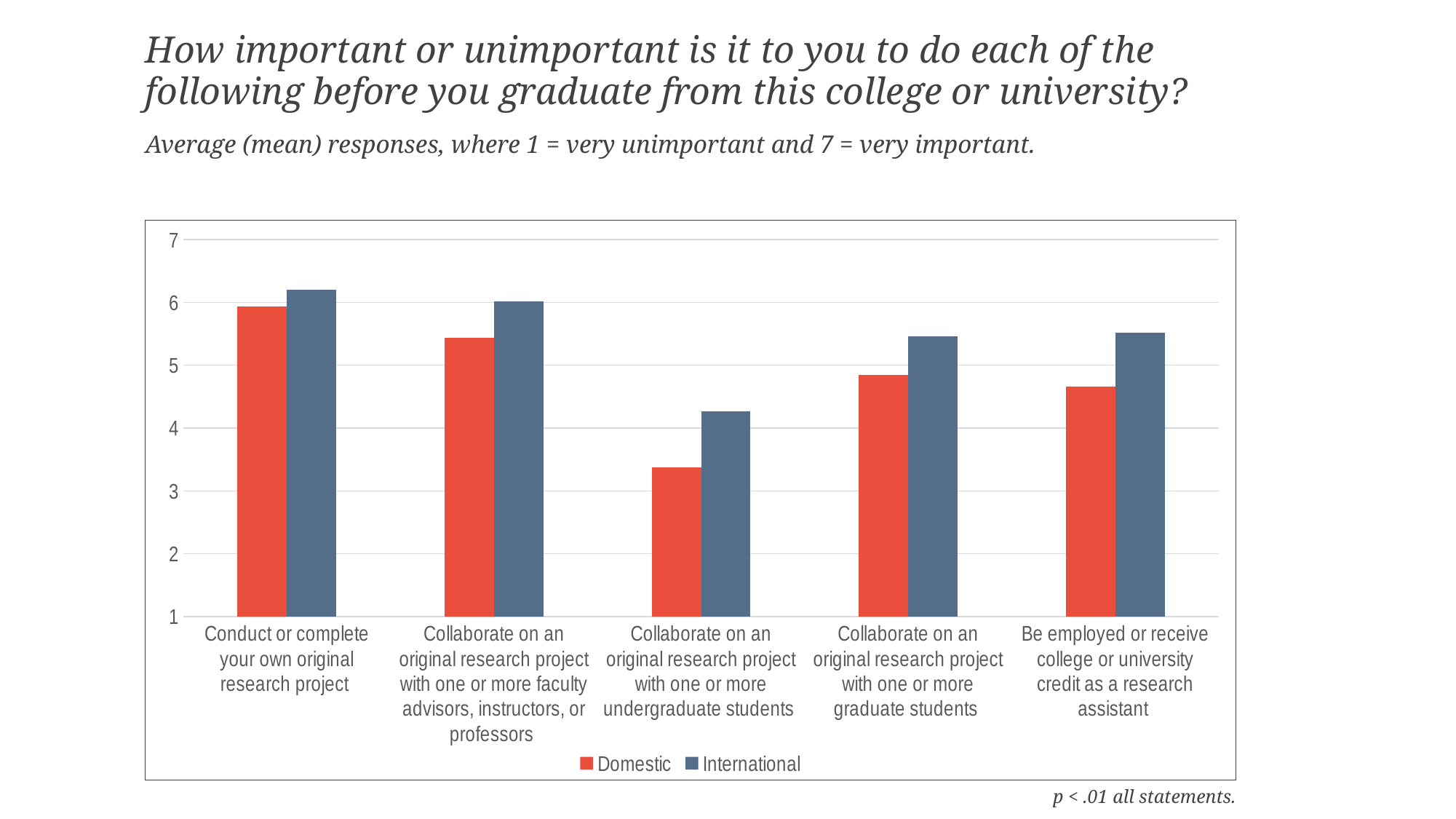
Is the International value for 'Collaborate on an original research project with one or more undergraduate students' greater or less than 4? greater Which series is shown in red in the legend? Domestic Is the International value for 'Conduct or complete your own original research project' greater or less than 6? greater Which category has the lowest International value? Collaborate on an original research project with one or more undergraduate students Is the Domestic value for 'Collaborate on an original research project with one or more undergraduate students' greater or less than 4? less How many series does the legend list? 2 Which category has the lowest Domestic value? Collaborate on an original research project with one or more undergraduate students For 'Collaborate on an original research project with one or more graduate students', which series has the larger value, Domestic or International? International What kind of chart is shown on the slide? bar chart How many categories are shown on the x axis? 5 Which category has the highest Domestic value? Conduct or complete your own original research project